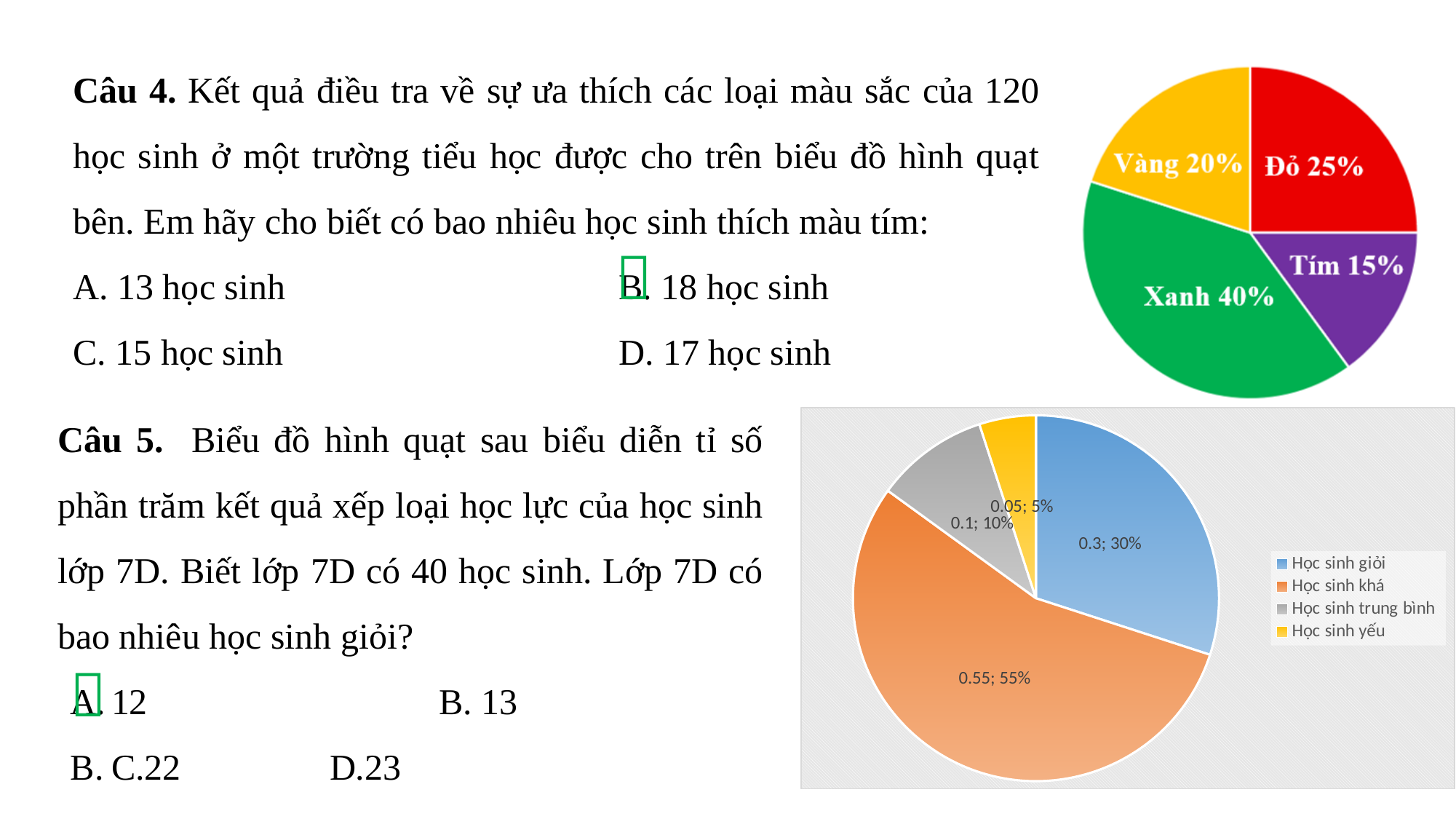
In the bottom-right pie chart, what percentage is shown for Học sinh yếu? 5% In the top-right pie chart, which colour has the largest slice? Xanh In the bottom-right pie chart, which is larger: Học sinh giỏi or Học sinh trung bình? Học sinh giỏi How many entries does the legend of the bottom-right pie chart list? 4 In the bottom-right pie chart, what percentage is shown for Học sinh khá? 55% In the top-right pie chart, which colour has the smallest slice? Tím In the top-right pie chart, how many slices are there? 4 In the top-right pie chart, what is the difference in percentage points between Đỏ and Vàng? 5 In the top-right pie chart, what percentage is shown for Xanh? 40% In the bottom-right pie chart, which category has the largest share? Học sinh khá What type of chart is the bottom-right chart? Pie chart In the top-right pie chart, what percentage is shown for Tím? 15%